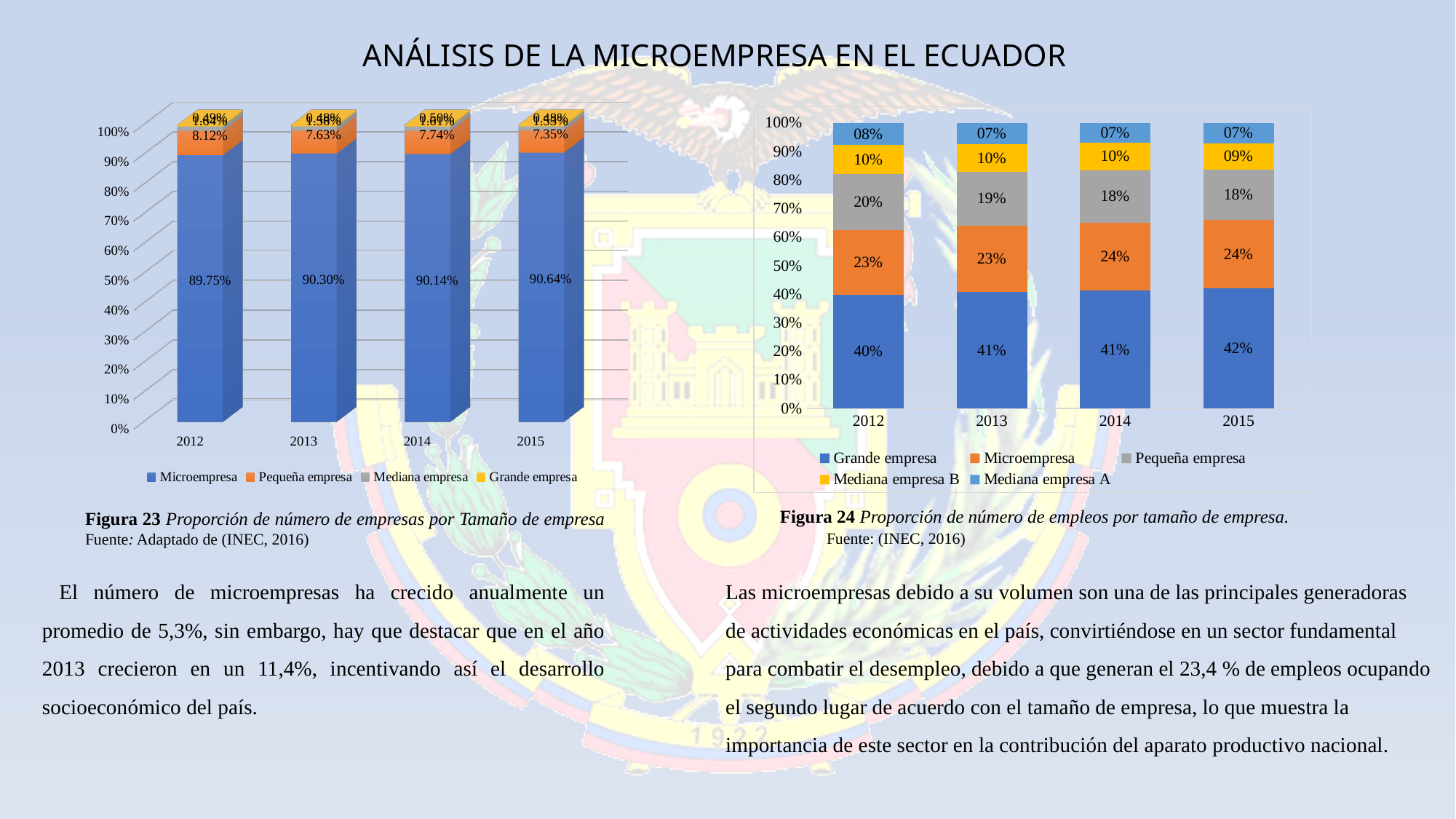
In the Figura 24 chart on the right, what is the value for Mediana empresa A in 2012? 08% In the Figura 23 chart on the left, what is the value for Microempresa in 2015? 90.64% In the Figura 24 chart on the right, which is larger in 2015: Microempresa or Pequeña empresa? Microempresa In the Figura 24 chart on the right, what is the value for Grande empresa in 2012? 40% In the Figura 23 chart on the left, what is the value for Pequeña empresa in 2012? 8.12% How many series does the legend of the Figura 24 chart on the right list? 5 In the Figura 23 chart on the left, which year has the lowest Microempresa value? 2012 In the Figura 23 chart on the left, what is the difference between the Pequeña empresa values for 2012 and 2015? 0.77% How many series does the legend of the Figura 23 chart on the left list? 4 In the Figura 24 chart on the right, does the Grande empresa value rise or fall from 2012 to 2015? rise What kind of chart is the Figura 24 chart on the right? stacked bar chart In the Figura 24 chart on the right, what is the value for Pequeña empresa in 2013? 19%